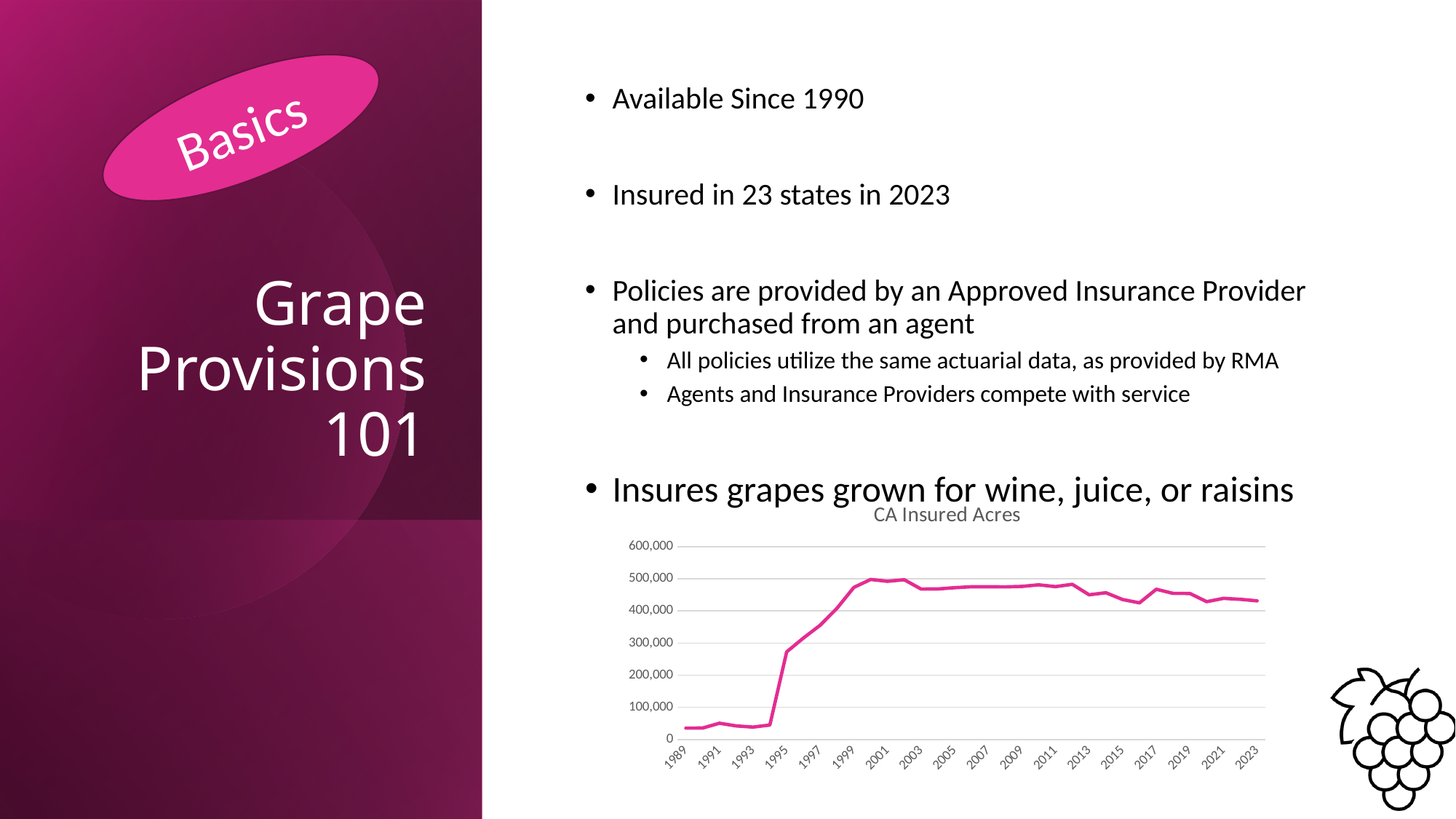
Is the value for 2023 in the CA Insured Acres chart greater or less than 400,000? greater What kind of chart is shown on the slide? line chart Is the value for 1997 in the CA Insured Acres chart greater or less than 300,000? greater Is the value for 2023 in the CA Insured Acres chart greater or less than 500,000? less Which is larger in the CA Insured Acres chart, the value for 1991 or the value for 2001? 2001 What is the title of the chart on the slide? CA Insured Acres Do the values in the CA Insured Acres chart rise or fall between 1989 and 1999? rise What is the highest value shown on the y axis of the CA Insured Acres chart? 600,000